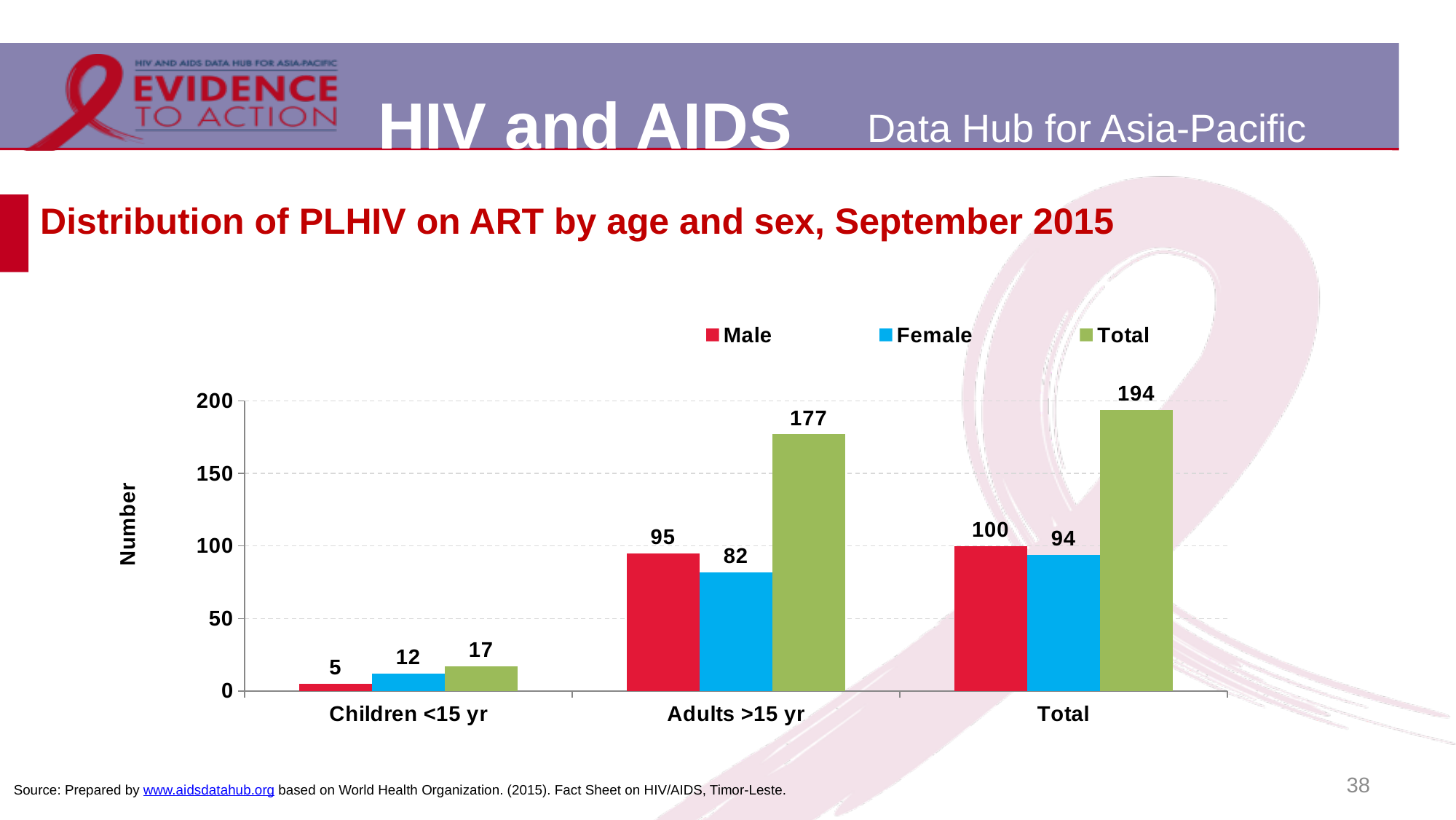
Which category has the lowest Male value? Children <15 yr What is the label of the y axis? Number What is the Total value for the Total category? 194 What kind of chart is shown on the slide? Bar chart How many series does the legend list? 3 What is the difference between the Male and Female values for Adults >15 yr? 13 What is the Male value for Adults >15 yr? 95 Which is larger for Children <15 yr, the Male value or the Female value? Female How many categories are shown on the x axis? 3 Is the Total value for Adults >15 yr greater or less than 150? greater What is the Female value for Children <15 yr? 12 Which category has the highest Female value? Total